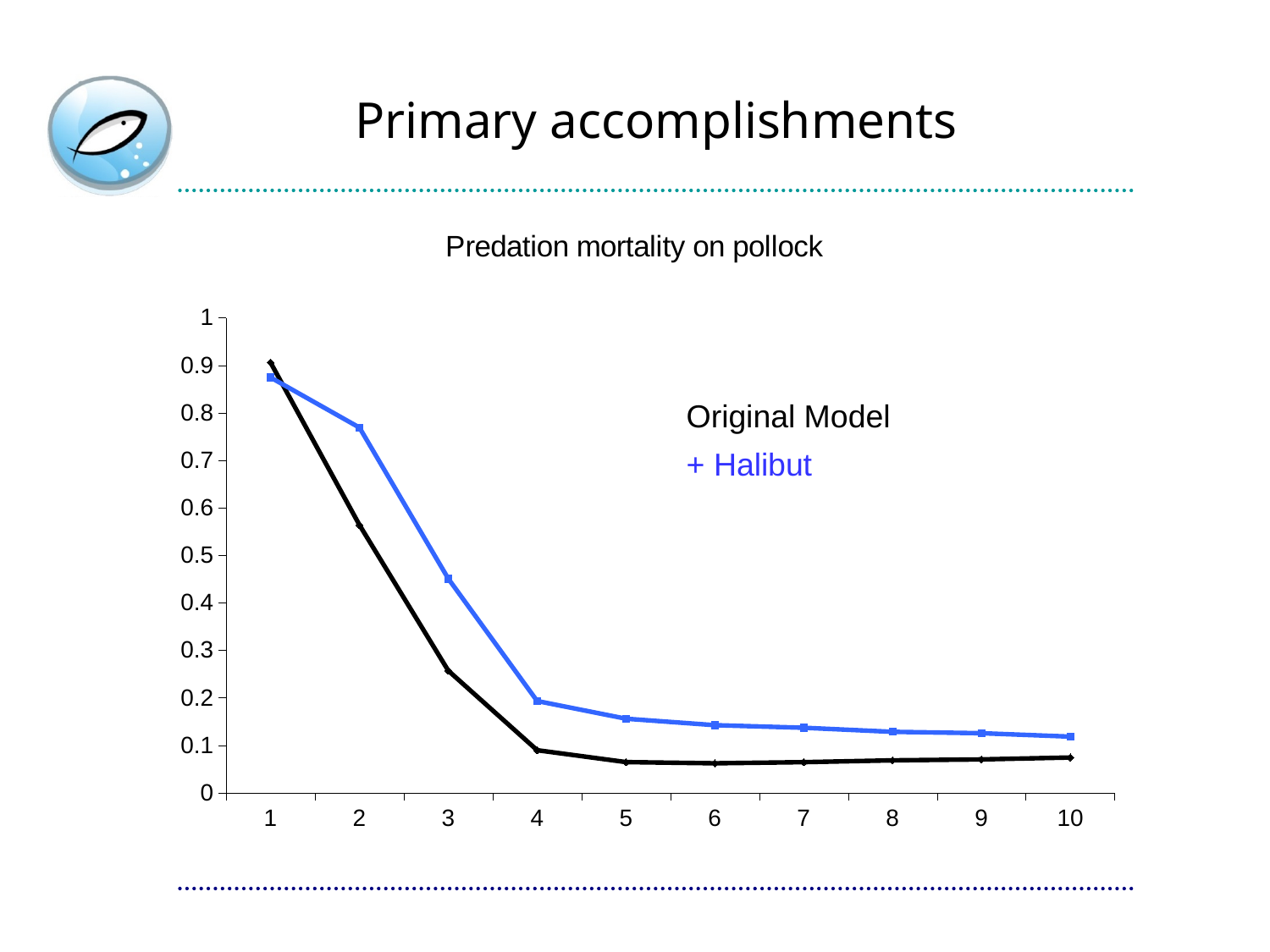
Is the value for + Halibut at x = 10 greater or less than 0.1? greater Is the value for Original Model at x = 3 greater or less than 0.3? less Is the value for + Halibut at x = 2 greater or less than 0.7? greater At x = 3, which series has the higher value, Original Model or + Halibut? + Halibut At which x value is the Original Model series highest? 1 At which x value is the + Halibut series highest? 1 Which series is drawn in blue? + Halibut Do the values of the Original Model series generally rise or fall from x = 1 to x = 10? fall How many series does the chart's legend list? 2 What kind of chart is shown on the slide? line chart How many points along the x axis does each series have? 10 What is the title of the chart? Predation mortality on pollock